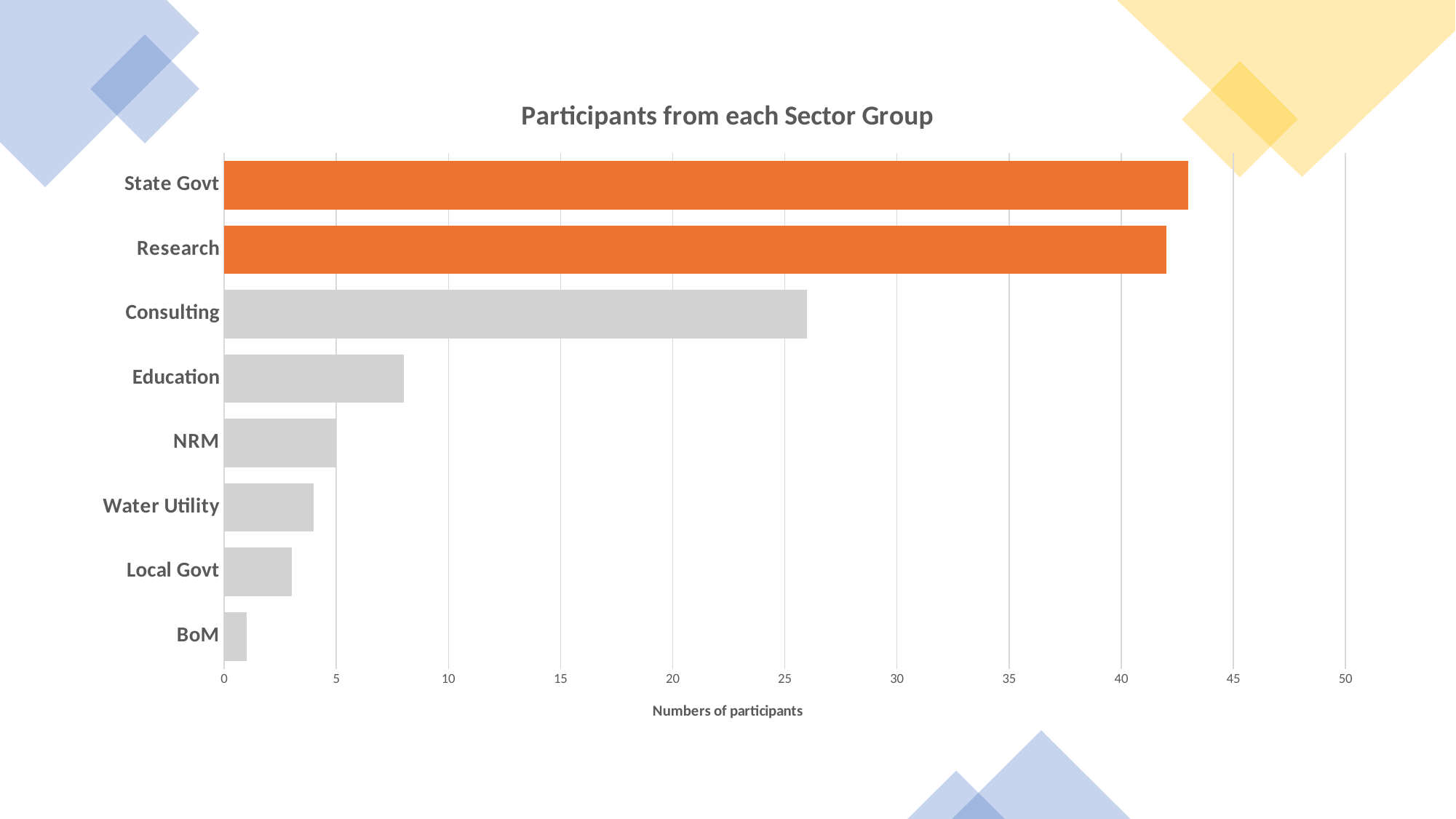
What is the label of the horizontal axis? Numbers of participants Which sector group has the lowest number of participants? BoM What is the number of participants for NRM? 5 How many sector groups are shown in the chart? 8 Is the value for Local Govt greater or less than 5? less Which has more participants, Consulting or Education? Consulting What is the title of the chart? Participants from each Sector Group Is the value for Education greater or less than 10? less Is the value for Consulting greater or less than 25? greater What type of chart is shown on the slide? bar chart Which has more participants, Water Utility or Local Govt? Water Utility